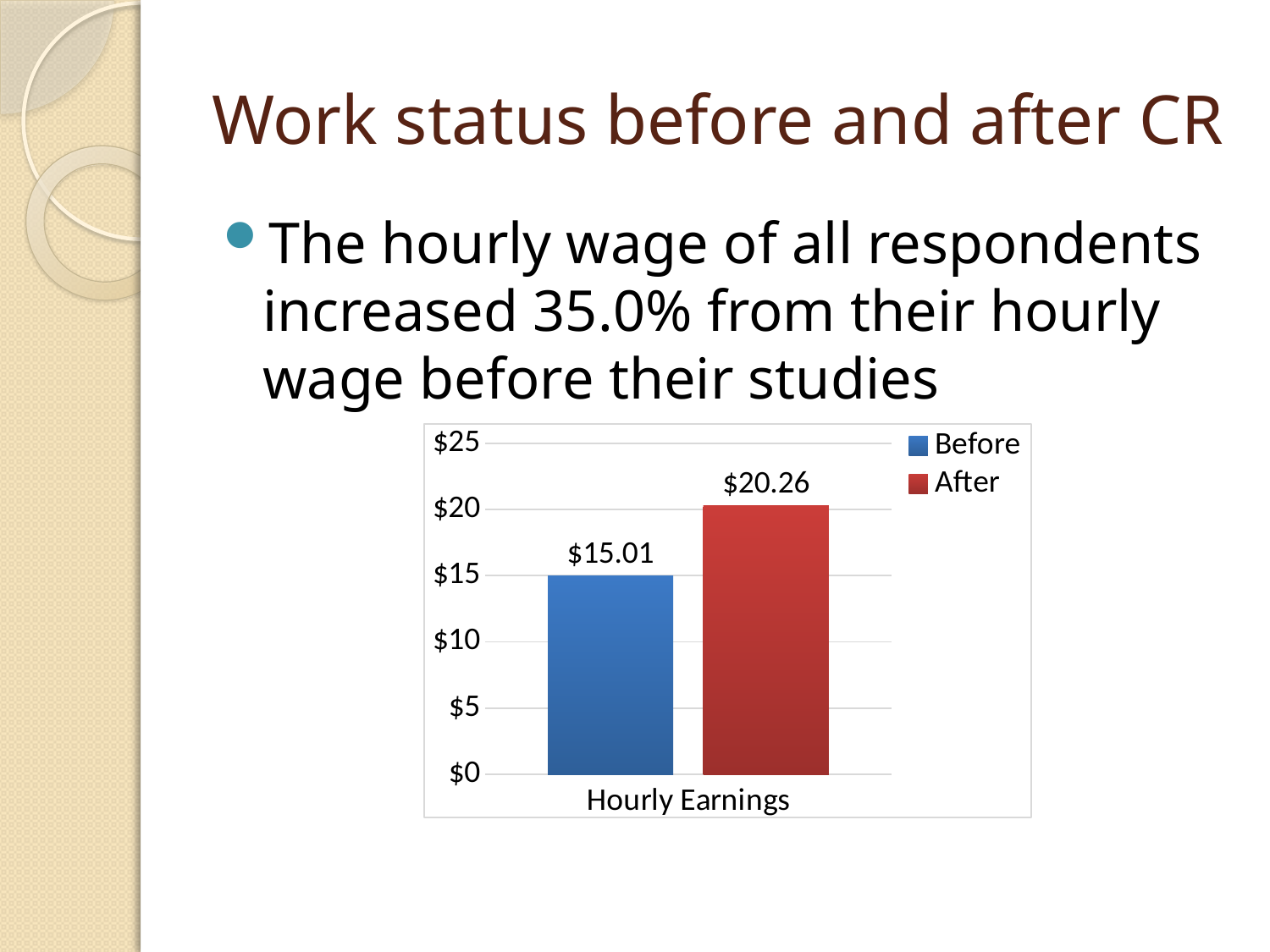
What kind of chart is shown on the slide? Bar chart What is the hourly earnings value for the Before series? $15.01 How many series does the legend list? 2 What is the category label on the x axis of the chart? Hourly Earnings What is the hourly earnings value for the After series? $20.26 Is the value for After greater or less than $20? greater What colour is the After series in the chart? Red Which series has the higher hourly earnings, Before or After? After Which series shows the lowest hourly earnings? Before How many categories are shown on the x axis of the chart? 1 Is the value for Before greater or less than $15? greater What is the difference between the After and Before hourly earnings? $5.25